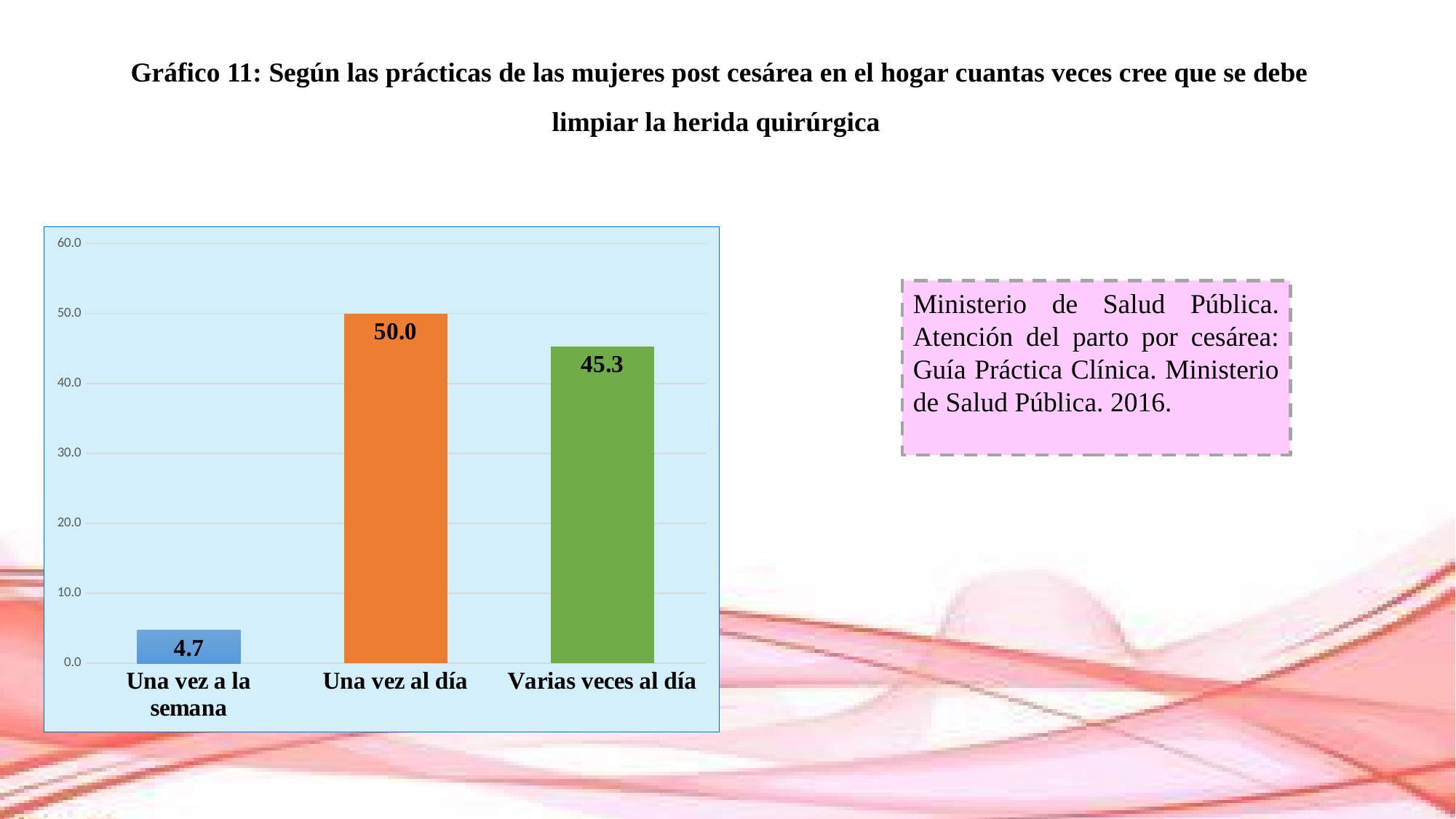
Which is larger, the value for "Una vez a la semana" or the value for "Varias veces al día"? Varias veces al día What kind of chart is shown on the slide? Bar chart Which category has the lowest value? Una vez a la semana What is the value for "Una vez a la semana"? 4.7 What is the value for "Una vez al día"? 50.0 Is the value for "Varias veces al día" greater or less than 40.0? greater What is the value for "Varias veces al día"? 45.3 What is the difference between the values for "Varias veces al día" and "Una vez a la semana"? 40.6 What colour is the bar for "Una vez al día"? Orange How many categories are shown on the x axis? 3 What is the difference between the values for "Una vez al día" and "Varias veces al día"? 4.7 Which category has the highest value? Una vez al día